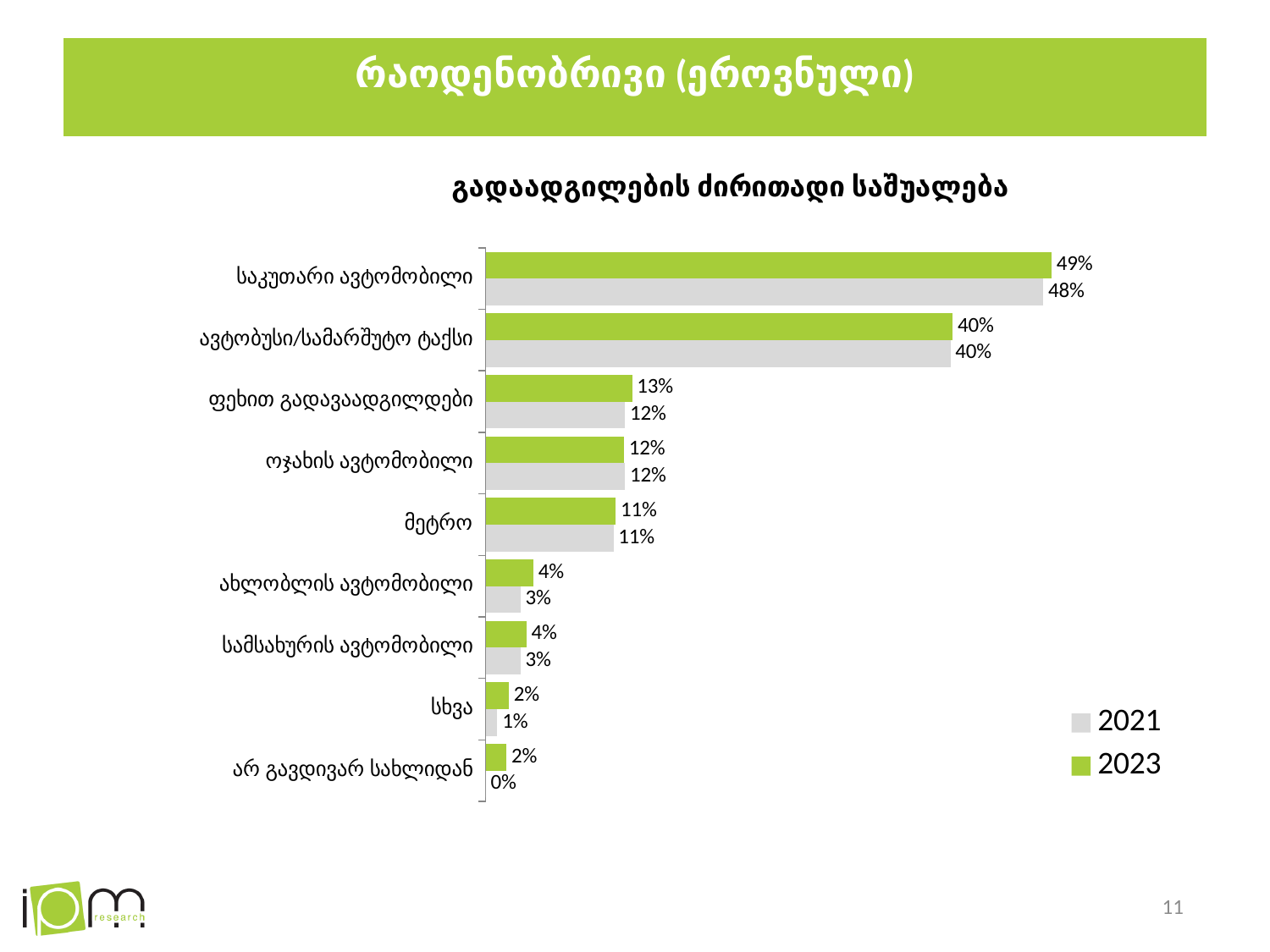
Which category has the lowest 2021 value? არ გავდივარ სახლიდან Which category has the highest 2023 value? საკუთარი ავტომობილი What is the 2021 value for არ გავდივარ სახლიდან? 0% What is the difference between the 2023 and 2021 values for საკუთარი ავტომობილი? 1% What is the 2021 value for ავტობუსი/სამარშუტო ტაქსი? 40% Which is larger for ახლობლის ავტომობილი, the 2021 value or the 2023 value? 2023 How many series does the legend list? 2 What is the difference between the 2023 values for ავტობუსი/სამარშუტო ტაქსი and ფეხით გადავადგილდები? 27% What is the 2023 value for მეტრო? 11% What type of chart is shown on the slide? Bar chart How many categories are shown on the chart? 9 What is the 2023 value for საკუთარი ავტომობილი? 49%